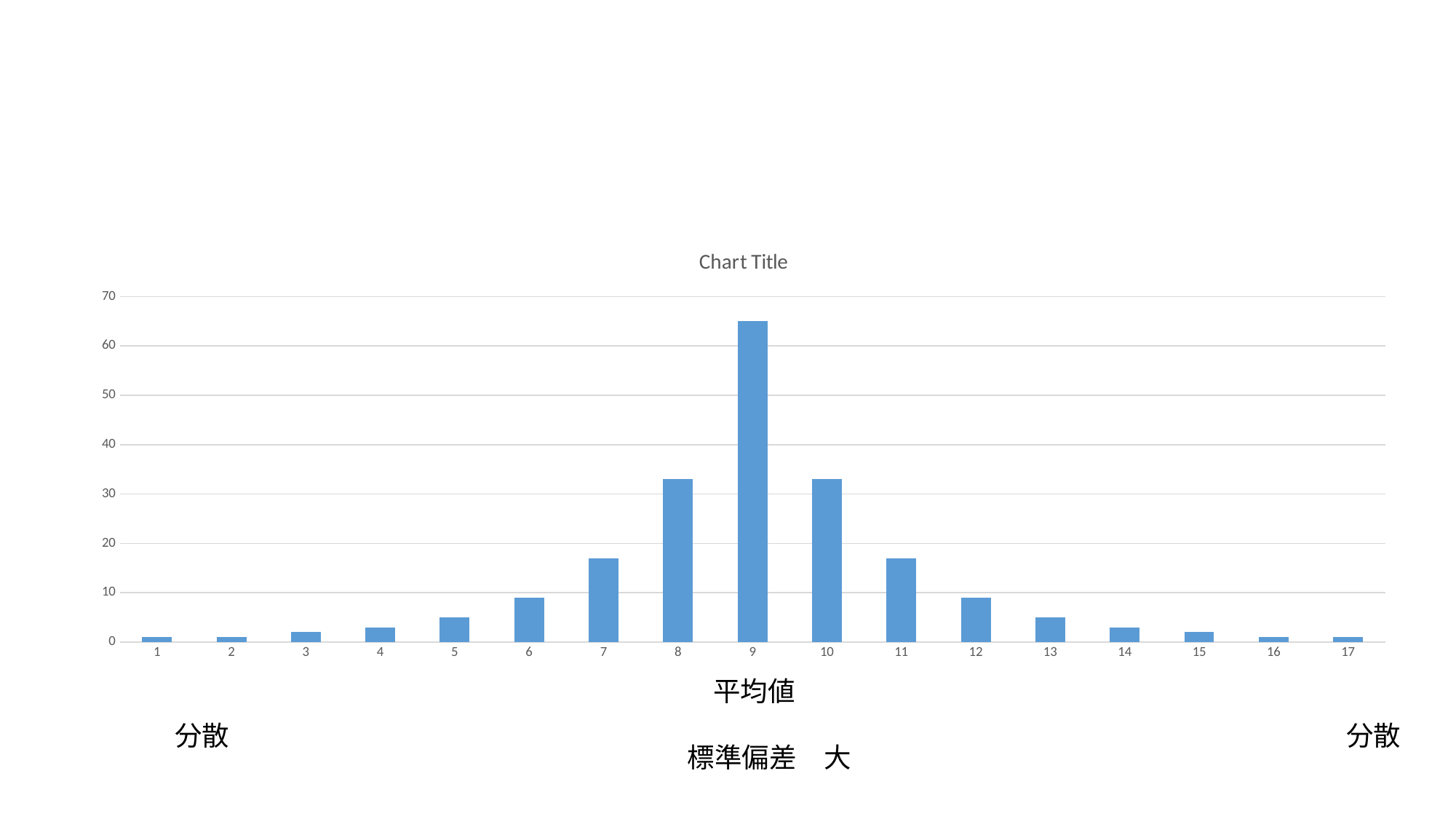
Which is larger, the value for category 7 or the value for category 6? category 7 Do the values rise or fall from category 9 to category 17? fall Which category has the highest bar? 9 Is the value for category 8 greater or less than 30? greater Is the value for category 7 greater or less than 20? less Is the value for category 10 greater or less than 30? greater How many categories are plotted along the x axis? 17 What kind of chart is shown on the slide? bar chart What is the title of the chart? Chart Title Which is larger, the value for category 9 or the value for category 8? category 9